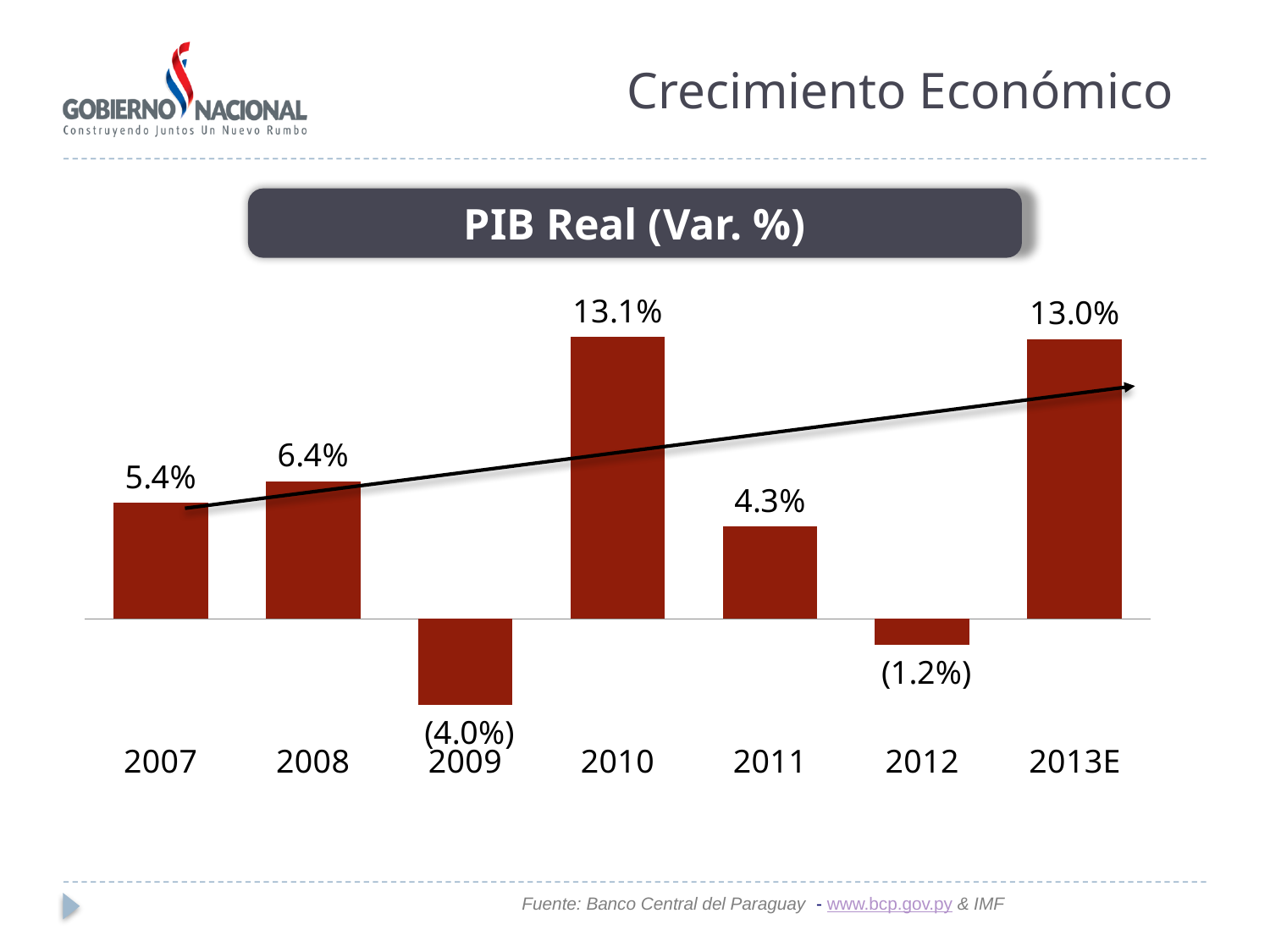
What is the title of the chart? PIB Real (Var. %) What is the difference between the values for 2010 and 2011? 8.8% Which year has the lowest value? 2009 What is the value for 2010? 13.1% What is the value for 2009? (4.0%) How many years are shown on the x axis? 7 Which is larger, the value for 2008 or the value for 2011? 2008 What kind of chart is this? bar chart Which year has the highest value? 2010 What is the difference between the values for 2008 and 2007? 1.0% What is the value for 2013E? 13.0% What is the value for 2012? (1.2%)